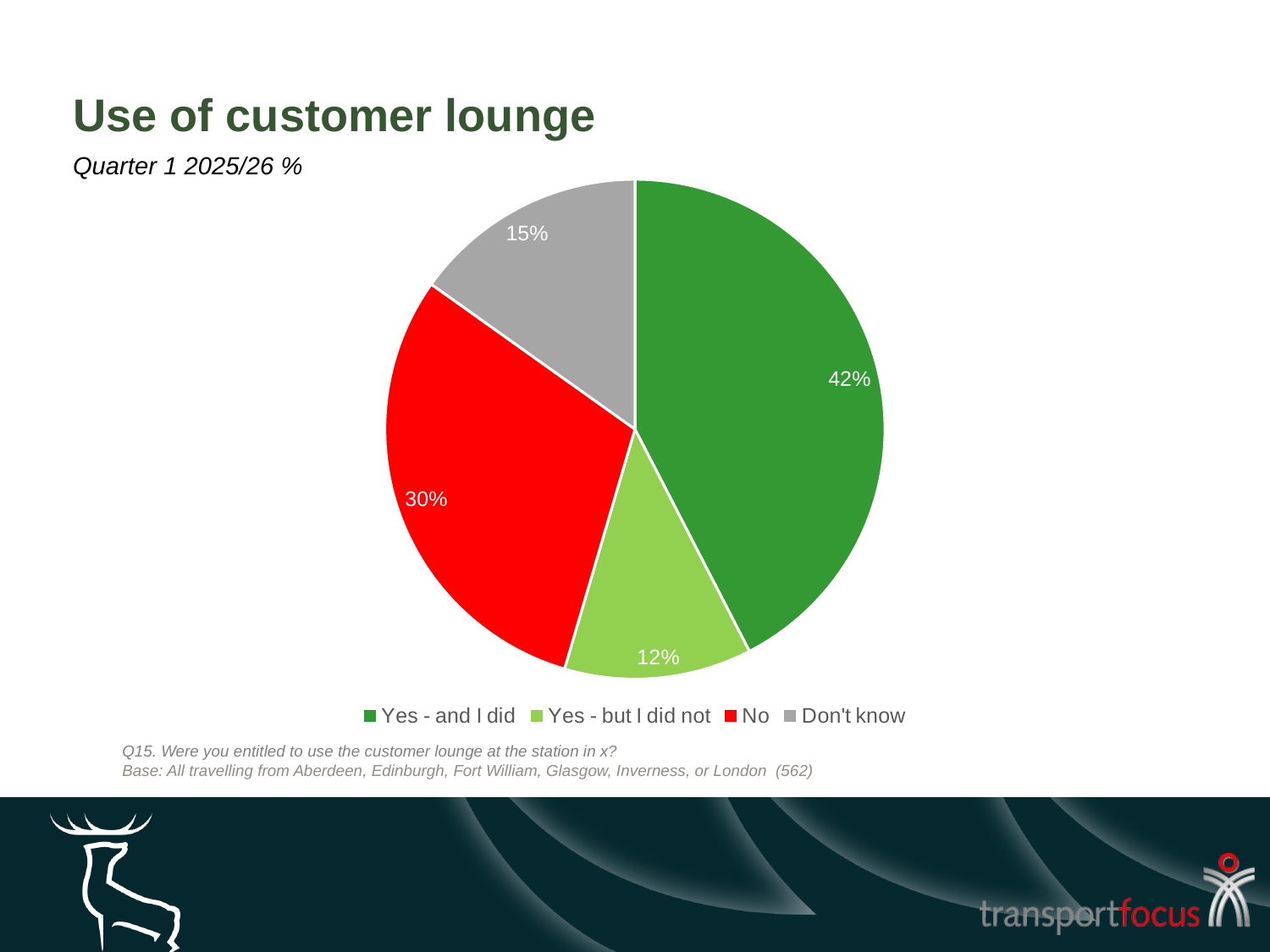
Which response has the largest share of the pie? Yes - and I did What percentage of respondents answered 'Yes - but I did not'? 12% What percentage of respondents answered 'No'? 30% How many categories does the pie chart show? 4 What percentage of respondents answered 'Don't know'? 15% What colour represents the 'No' response in the chart? Red What is the title of the chart? Use of customer lounge Which is larger: the share for 'Don't know' or the share for 'Yes - but I did not'? Don't know What percentage of respondents answered 'Yes - and I did'? 42% Which response has the smallest share of the pie? Yes - but I did not What is the difference in percentage points between 'Yes - and I did' and 'No'? 12 What type of chart is shown on the slide? Pie chart